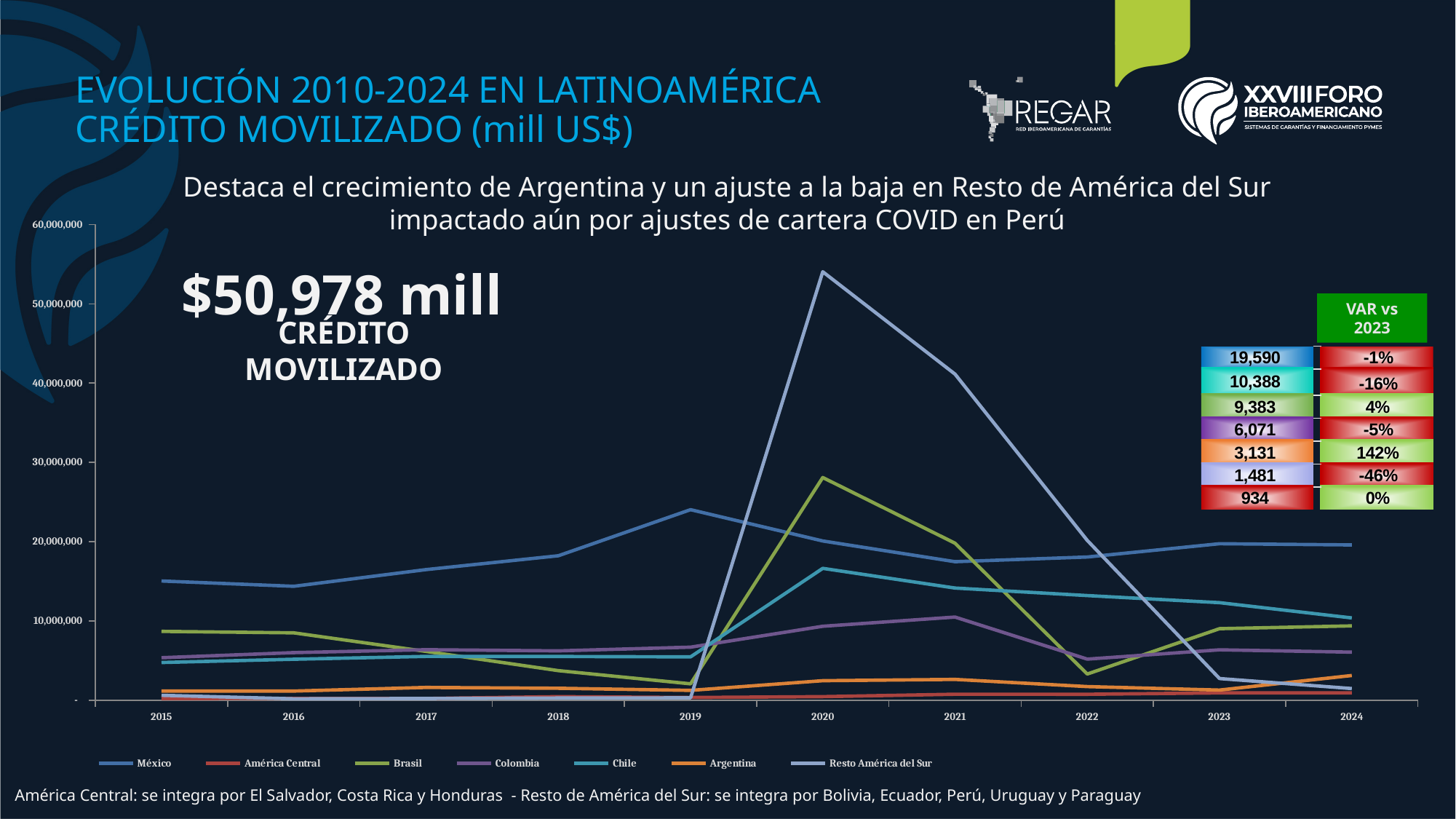
Is the value for Resto América del Sur in 2020 greater or less than 50,000,000? greater In 2022, which series has the larger value, Brasil or Colombia? Colombia How many years are shown along the x axis of the chart? 10 Does the line for Resto América del Sur rise or fall from 2020 to 2024? fall How many series does the legend of the chart list? 7 In 2024, which series has the larger value, México or Chile? México What is the first year shown on the x axis of the chart? 2015 Which series reaches the highest value on the chart in 2020? Resto América del Sur Is the value for Brasil in 2020 greater or less than 20,000,000? greater Is the value for México in 2019 greater or less than 20,000,000? greater What kind of chart is shown on the slide? line chart